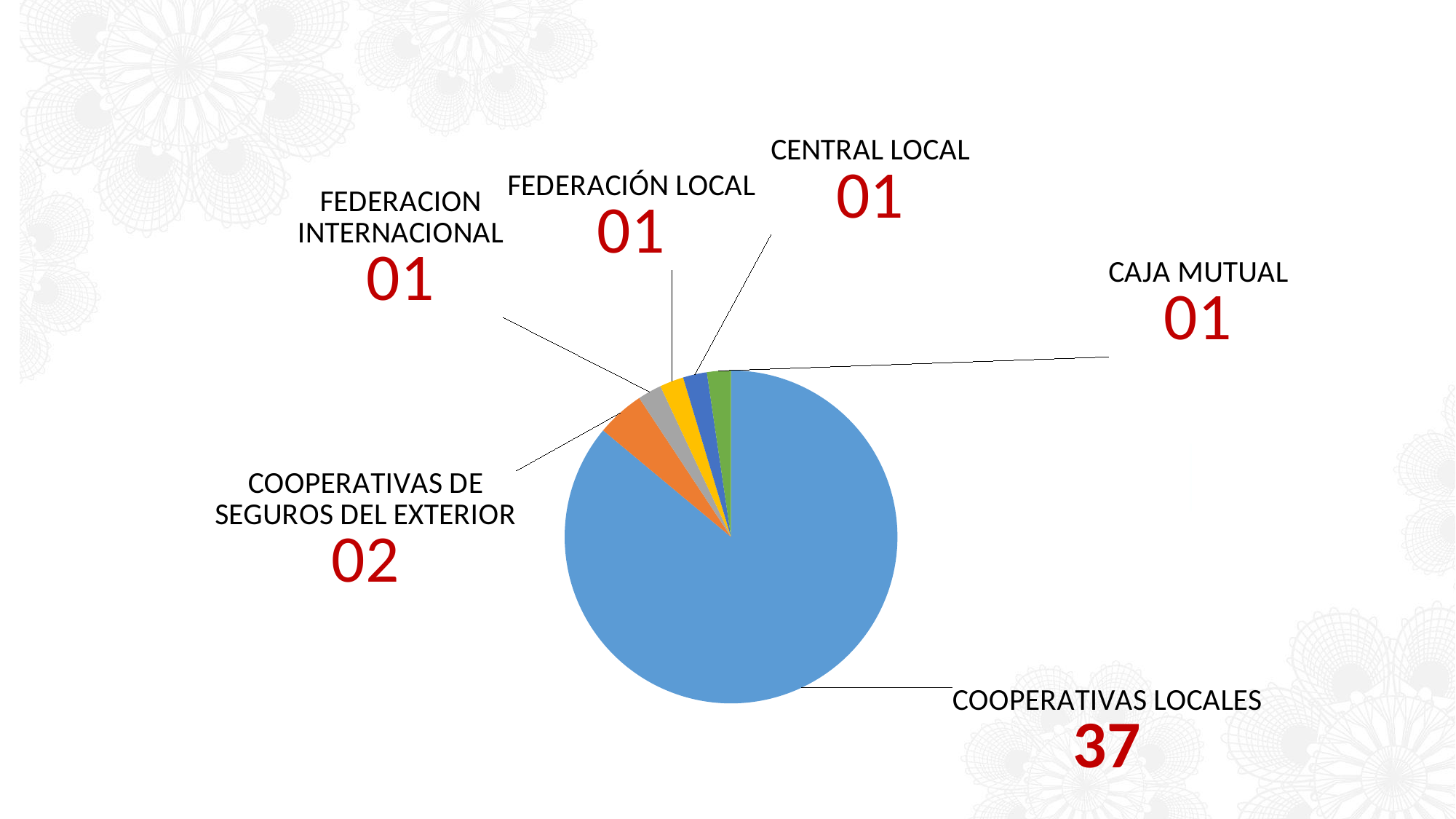
What is the difference between the values for COOPERATIVAS DE SEGUROS DEL EXTERIOR and CENTRAL LOCAL? 1 Which is larger, the value for COOPERATIVAS DE SEGUROS DEL EXTERIOR or the value for FEDERACIÓN LOCAL? COOPERATIVAS DE SEGUROS DEL EXTERIOR What value is shown for COOPERATIVAS LOCALES in the pie chart? 37 What is the total of all the values shown in the pie chart? 43 What value is shown for FEDERACION INTERNACIONAL in the pie chart? 01 What value is shown for CAJA MUTUAL in the pie chart? 01 What kind of chart is shown on the slide? Pie chart What value is shown for COOPERATIVAS DE SEGUROS DEL EXTERIOR in the pie chart? 02 How many categories are shown in the pie chart? 6 Which category has the largest slice of the pie chart? COOPERATIVAS LOCALES What colour is the slice for COOPERATIVAS LOCALES? Blue What is the difference between the values for COOPERATIVAS LOCALES and COOPERATIVAS DE SEGUROS DEL EXTERIOR? 35